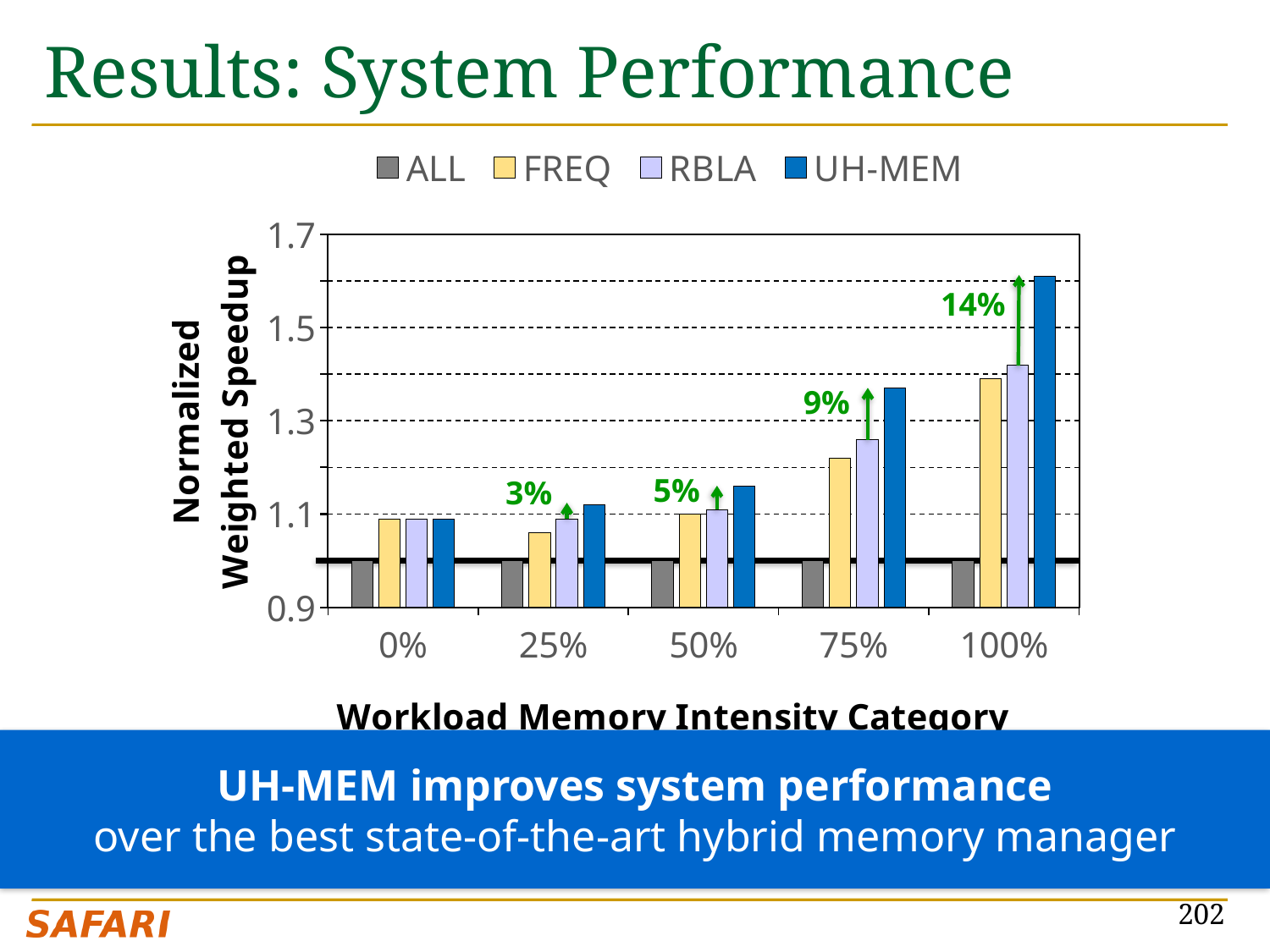
Do the UH-MEM values rise or fall as the workload memory intensity category increases from 0% to 100%? rise What kind of chart is shown on the slide? bar chart Is the UH-MEM value for the 75% category greater or less than 1.3? greater Is the FREQ value for the 25% category greater or less than 1.1? less Which series has the lowest bar in the 100% category? ALL Which is larger in the 75% category, the RBLA bar or the UH-MEM bar? UH-MEM What improvement percentage is annotated above the 100% category? 14% Is the UH-MEM value for the 100% category greater or less than 1.5? greater How many series does the legend list? 4 How many workload memory intensity categories are shown on the x axis? 5 In which category does UH-MEM reach its highest normalized weighted speedup? 100% Which series has the highest bar in the 100% category? UH-MEM